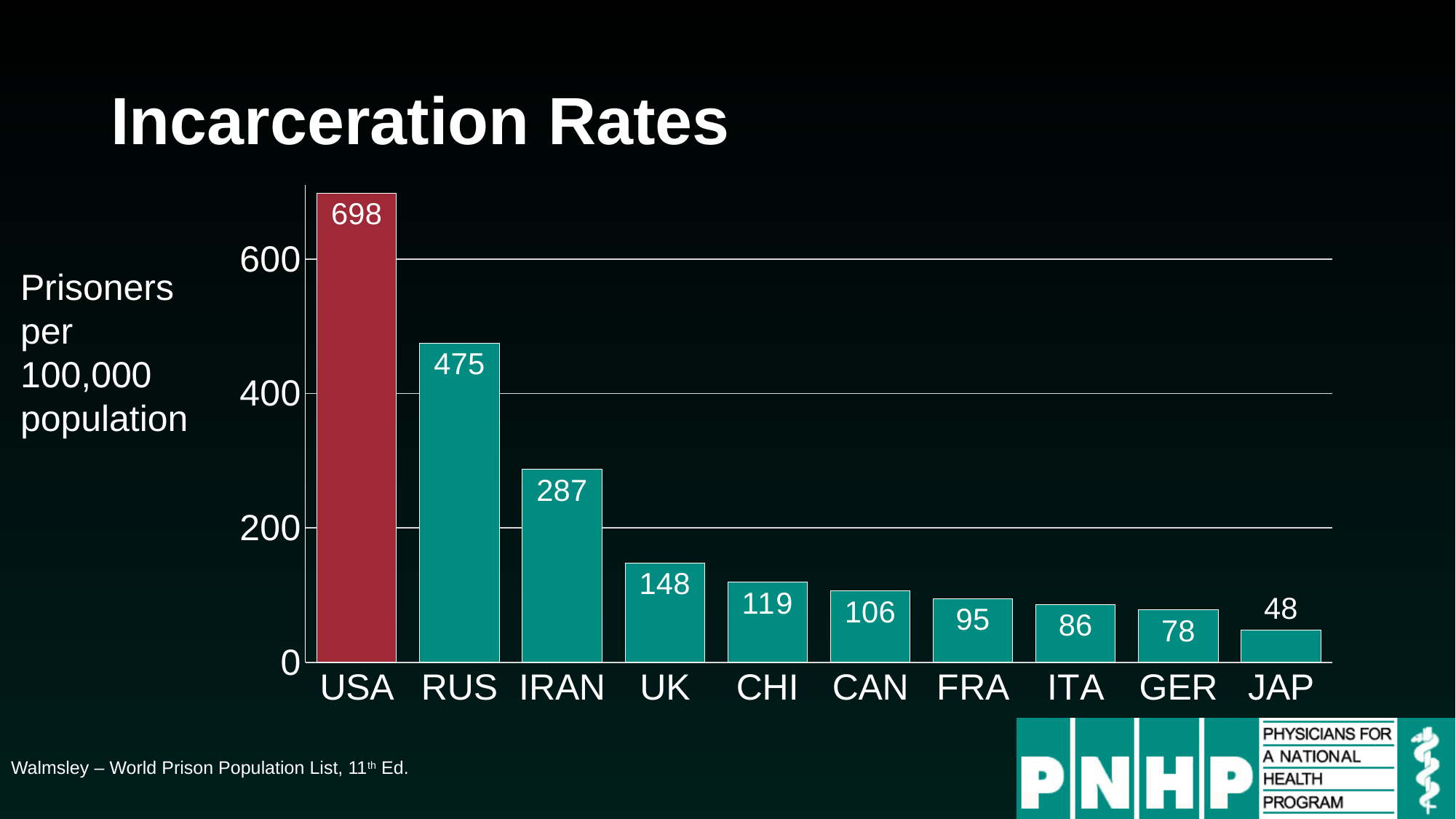
What is the value shown for JAP? 48 How many countries are shown in the chart? 10 What is the difference between the values for UK and GER? 70 What kind of chart is shown on the slide? Bar chart What is the difference between the values for USA and RUS? 223 Which country has the highest incarceration rate? USA What is the incarceration rate for the USA? 698 Which country has the lowest incarceration rate? JAP What is the value shown for RUS? 475 Which bar is coloured differently (red) from the others? USA What is the value shown for CAN? 106 Which has a higher value, IRAN or UK? IRAN